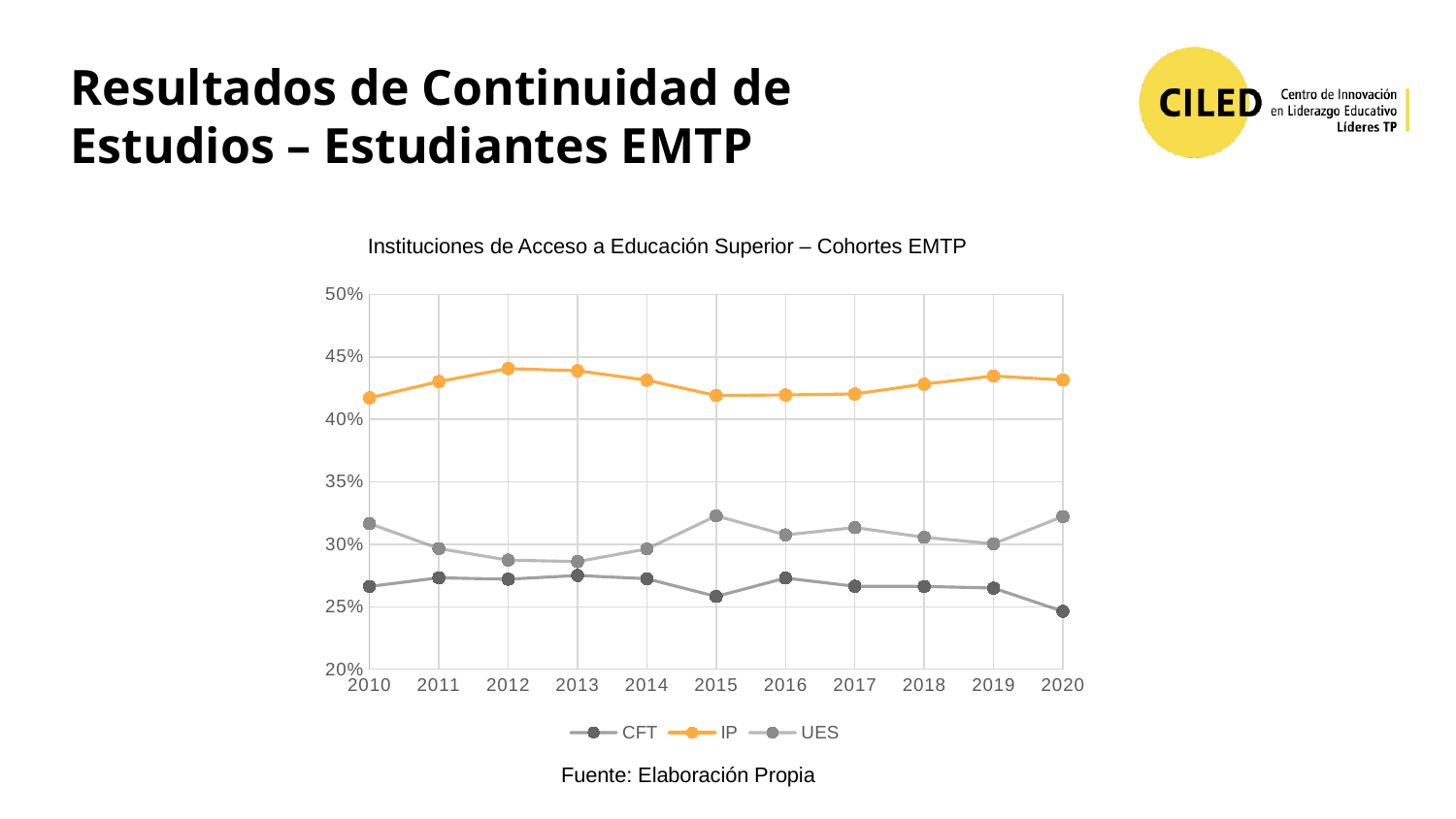
Is the value for IP in 2012 greater or less than 40%? greater Which is larger for UES: the value in 2013 or the value in 2015? 2015 What kind of chart is shown on the slide? line chart Is the value for UES in 2010 greater or less than 30%? greater Is the value for CFT in 2020 greater or less than 25%? less Which series has the lowest values across all years? CFT What is the title of the chart? Instituciones de Acceso a Educación Superior – Cohortes EMTP Which series has the highest values across all years? IP How many years are plotted along the x axis? 11 How many series does the legend list? 3 In which year does CFT reach its lowest value? 2020